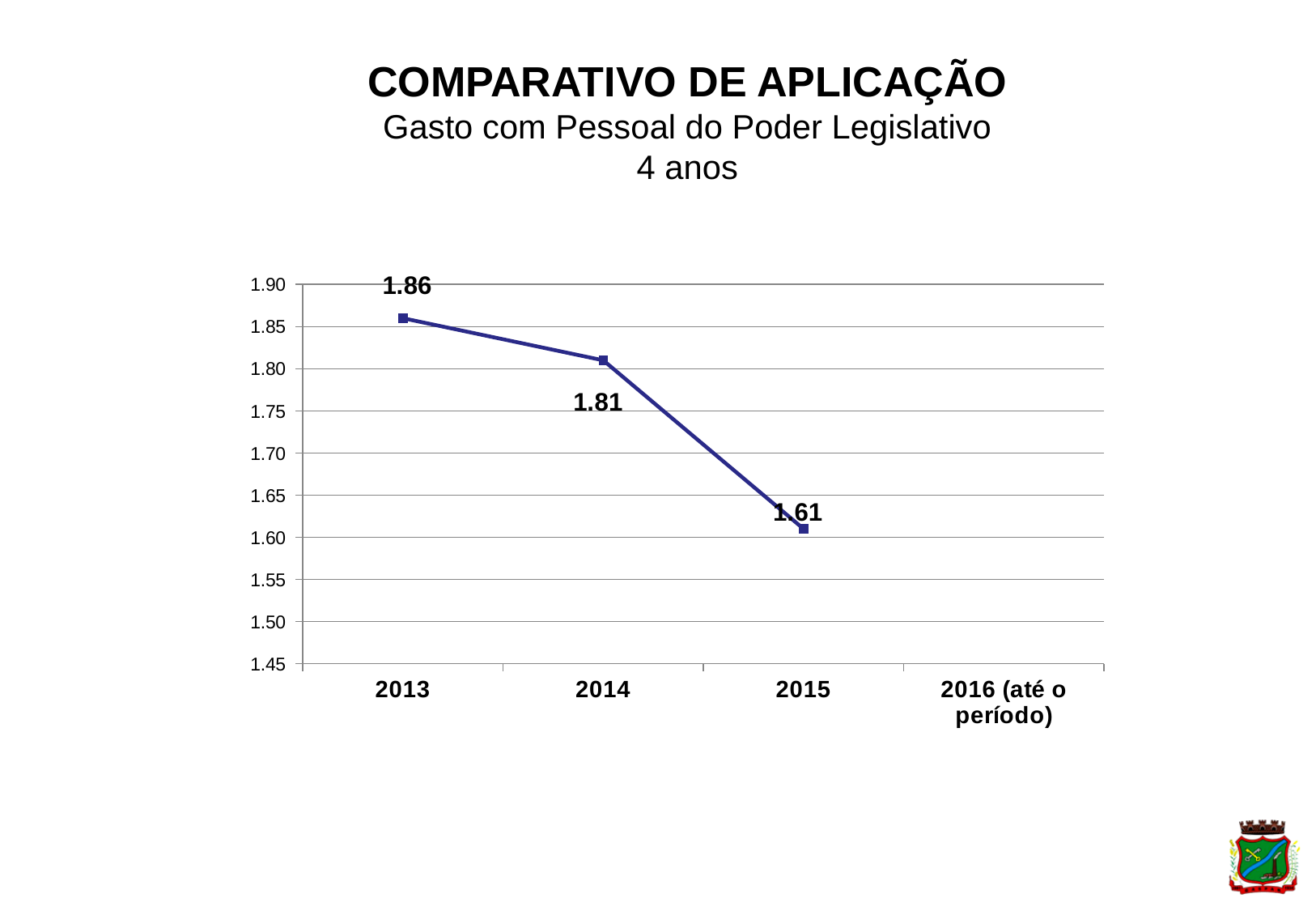
Do the values rise or fall from 2013 to 2015? fall How many categories are shown on the x axis? 4 Which year has the highest value? 2013 What is the value for 2015? 1.61 What is the difference between the values for 2014 and 2015? 0.20 What is the value for 2014? 1.81 What is the difference between the values for 2013 and 2015? 0.25 Which is larger, the value for 2013 or the value for 2014? 2013 What is the value for 2013? 1.86 What kind of chart is this? line chart Is the value for 2015 greater or less than 1.70? less Which year has the lowest plotted value? 2015